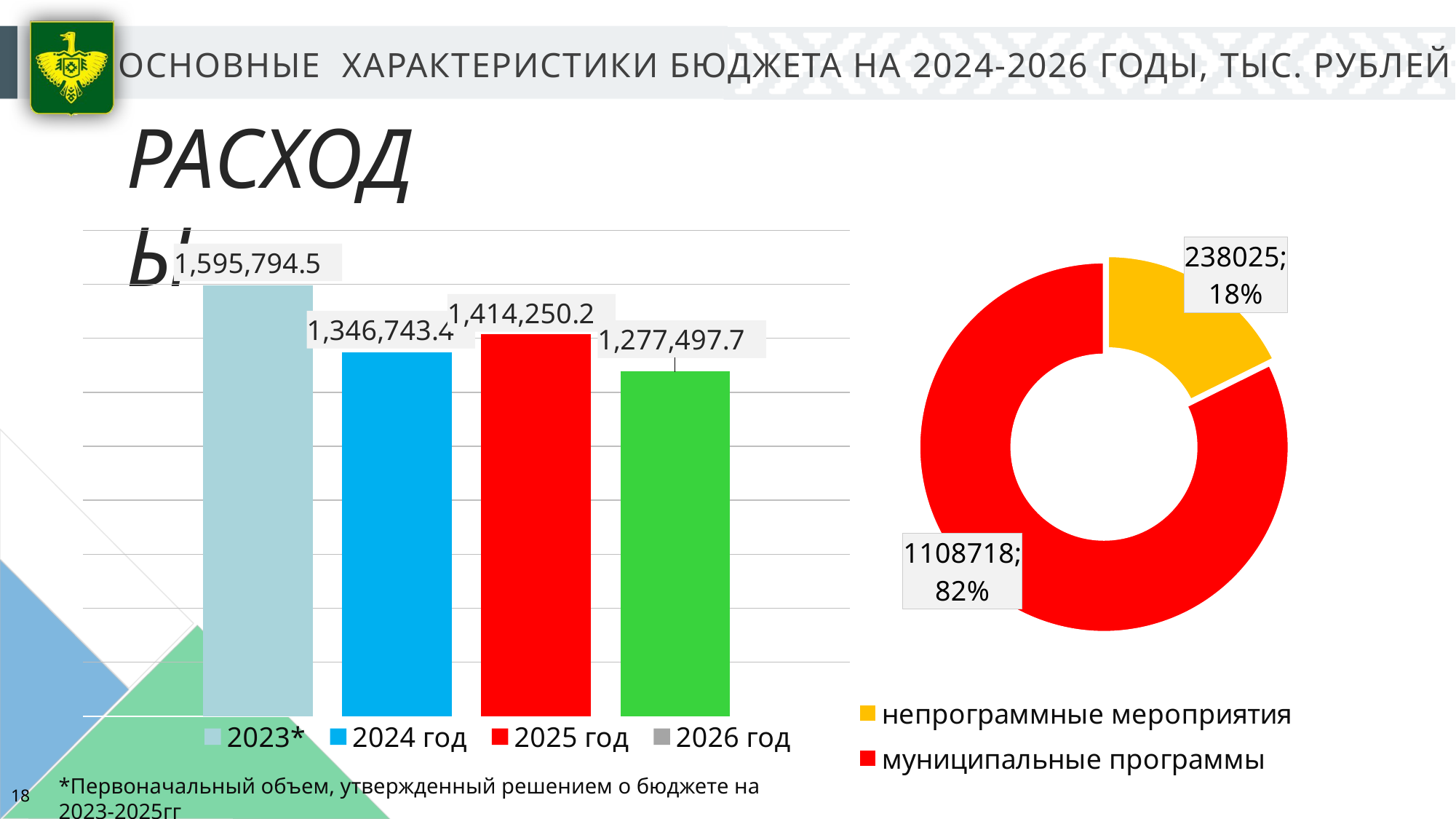
In the doughnut chart on the right, what is the value for непрограммные мероприятия? 238025 In the bar chart on the left, which is larger: the value for 2024 год or the value for 2025 год? 2025 год What kind of chart is shown on the left of the slide? Bar chart In the bar chart on the left, how many entries does the legend list? 4 In the bar chart on the left, what is the value for 2023*? 1,595,794.5 In the bar chart on the left, what is the difference between the values for 2025 год and 2026 год? 136,752.5 In the doughnut chart on the right, what share does муниципальные программы have? 82% In the bar chart on the left, what is the value for 2025 год? 1,414,250.2 In the bar chart on the left, what is the value for 2026 год? 1,277,497.7 In the doughnut chart on the right, which colour represents непрограммные мероприятия? Yellow In the bar chart on the left, which year has the highest value? 2023* In the bar chart on the left, which year has the lowest value? 2026 год